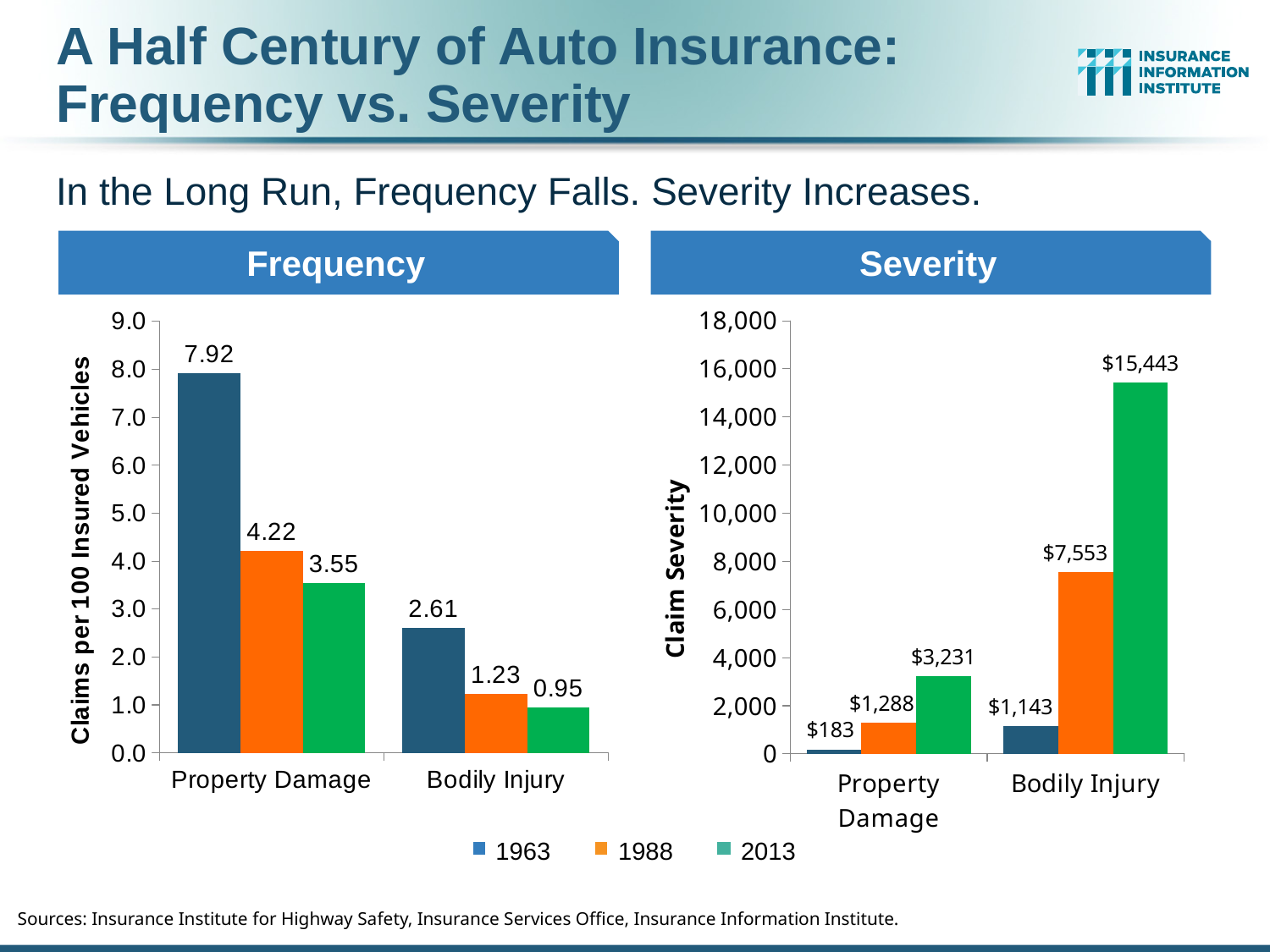
In the Frequency chart, what is the difference between the Property Damage values for 1963 and 2013? 4.37 What kind of chart is the Frequency chart? Bar chart In the Severity chart, what is the claim severity for Bodily Injury in 2013? $15,443 In the Frequency chart, do the Bodily Injury values rise or fall from 1963 to 2013? Fall In the Severity chart, which category and year has the lowest value? Property Damage, 1963 In the Severity chart, what is the difference between the Bodily Injury values for 2013 and 1988? $7,890 In the Frequency chart, what is the value for Property Damage in 1963? 7.92 In the Severity chart, which is larger: Property Damage in 2013 or Bodily Injury in 1988? Bodily Injury in 1988 How many series does the legend list? 3 In the Frequency chart, what is the value for Bodily Injury in 2013? 0.95 In the Severity chart, what is the claim severity for Property Damage in 1963? $183 In the Frequency chart, which category and year has the highest value? Property Damage, 1963